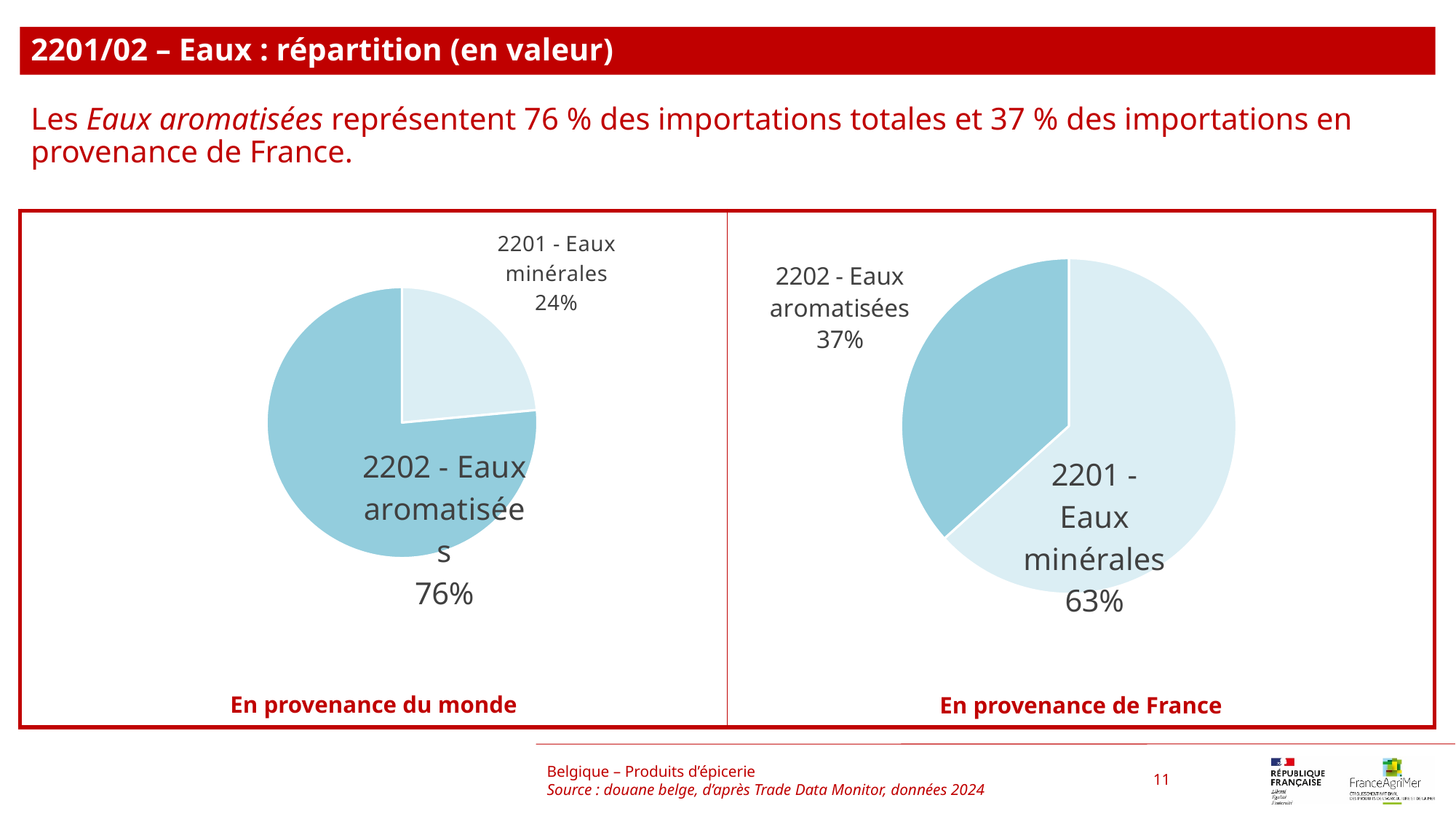
How many pie charts are shown on the slide? 2 In the 'En provenance de France' chart, what share does '2201 - Eaux minérales' have? 63% In the 'En provenance du monde' chart, which category has the largest slice? 2202 - Eaux aromatisées Which is larger: the share of '2202 - Eaux aromatisées' in the 'En provenance du monde' chart or in the 'En provenance de France' chart? En provenance du monde In the 'En provenance du monde' chart, what is the difference between the shares of '2202 - Eaux aromatisées' and '2201 - Eaux minérales'? 52 percentage points In the 'En provenance de France' chart, what is the difference between the shares of '2201 - Eaux minérales' and '2202 - Eaux aromatisées'? 26 percentage points In the 'En provenance de France' chart, which category has the smallest slice? 2202 - Eaux aromatisées In the 'En provenance de France' chart, what share does '2202 - Eaux aromatisées' have? 37% How many categories does the 'En provenance du monde' chart show? 2 In the 'En provenance du monde' chart, what share does '2201 - Eaux minérales' have? 24% What type of chart is the 'En provenance de France' chart? Pie chart